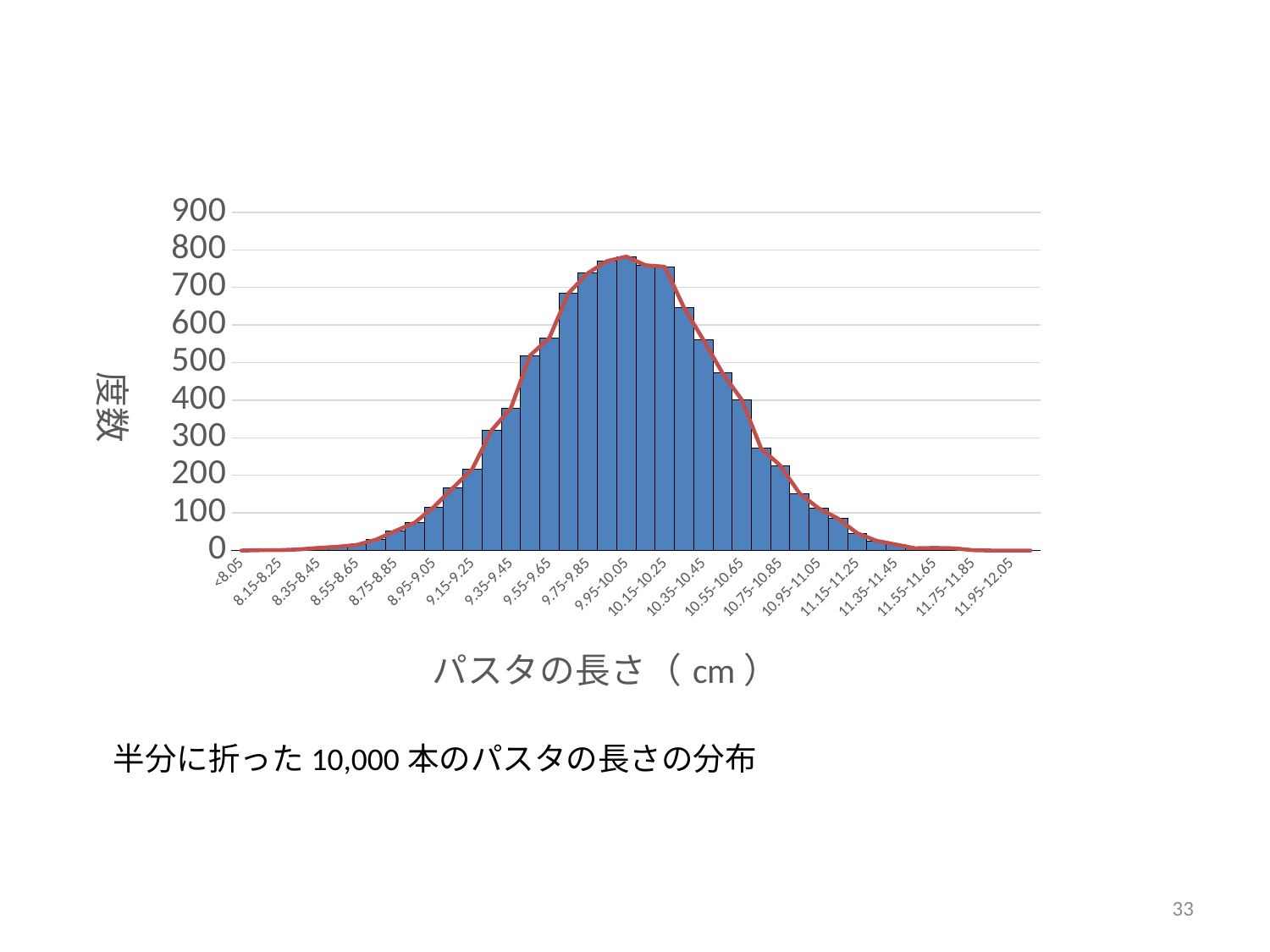
Which length bin has the highest frequency? 9.95-10.05 Is the value for 8.15-8.25 greater or less than 100? less Is the value for 11.95-12.05 greater or less than 100? less What is the title of the vertical axis? 度数 What kind of chart is shown on the slide? bar chart (histogram) with a line overlay Is the value for 9.95-10.05 greater or less than 700? greater Do the values rise or fall along the x axis from <8.05 to 9.95-10.05? rise Which is larger, the value for 8.75-8.85 or the value for 9.55-9.65? 9.55-9.65 What is the title of the horizontal axis? パスタの長さ（cm） Do the values rise or fall along the x axis from 10.15-10.25 to 11.95-12.05? fall